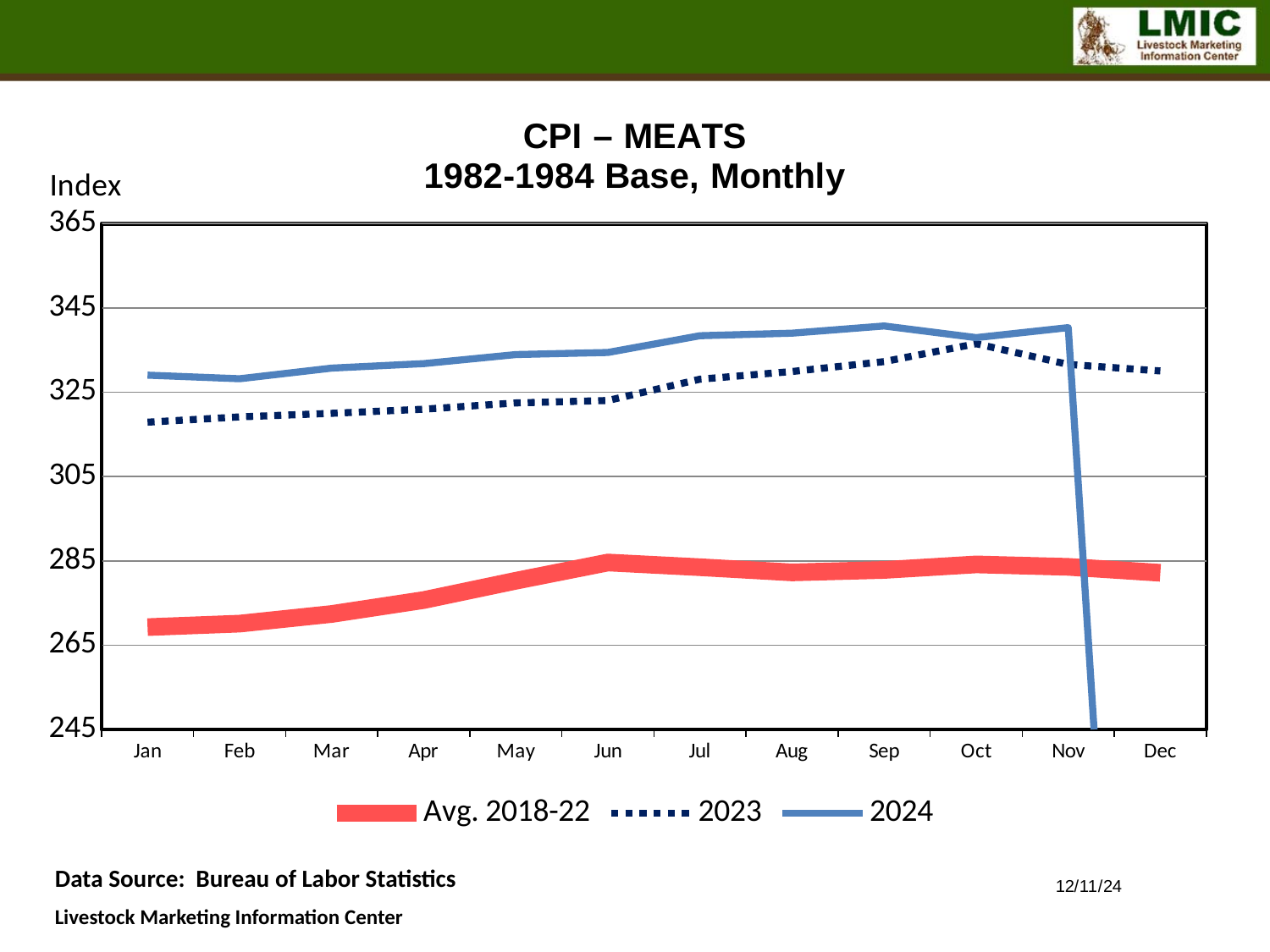
In which month is the Avg. 2018-22 series at its lowest value? Jan Is the 2024 value for Jan greater or less than 325? greater How many series does the legend list? 3 Does the 2023 series rise or fall from Jan to Oct? rise Is the 2023 value for Jan greater or less than 325? less In which month does the 2023 series reach its highest value? Oct What is the title of the chart? CPI – MEATS 1982-1984 Base, Monthly Is the 2024 value for Sep greater or less than 345? less How many months are shown along the x axis? 12 In Jan, which series is higher: 2023 or 2024? 2024 What kind of chart is shown on the slide? Line chart